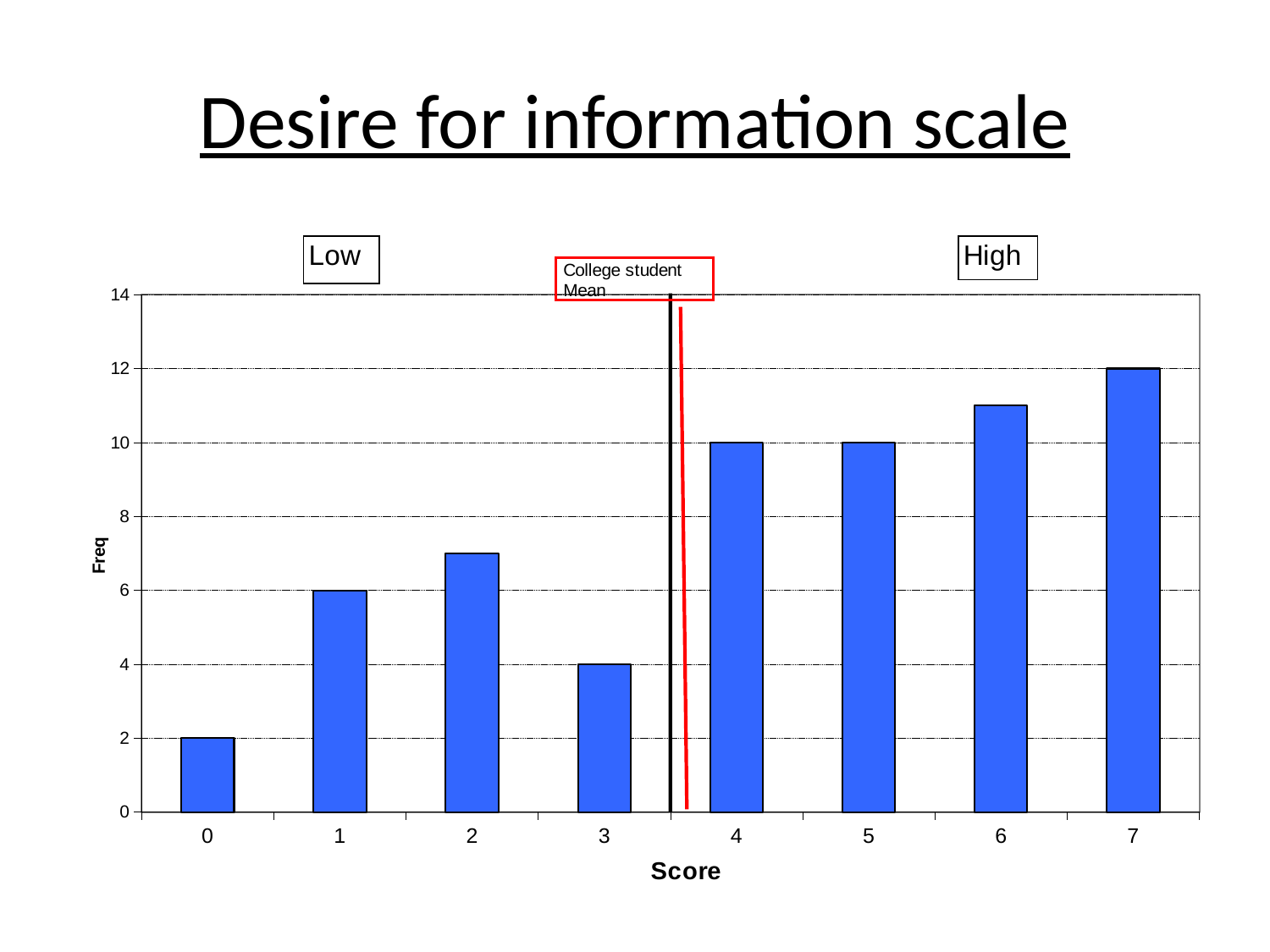
Is the frequency for score 2 greater or less than 6? greater What type of chart is shown on the slide? Bar chart What is the frequency for score 3? 4 How many score categories are shown on the x axis? 8 Which has a higher frequency, score 1 or score 3? Score 1 Which score has the highest frequency? 7 What is the frequency for score 7? 12 What is the difference in frequency between score 7 and score 0? 10 Which score has the lowest frequency? 0 Is the frequency for score 6 greater or less than 12? less What is the frequency for score 4? 10 What is the frequency for score 0? 2